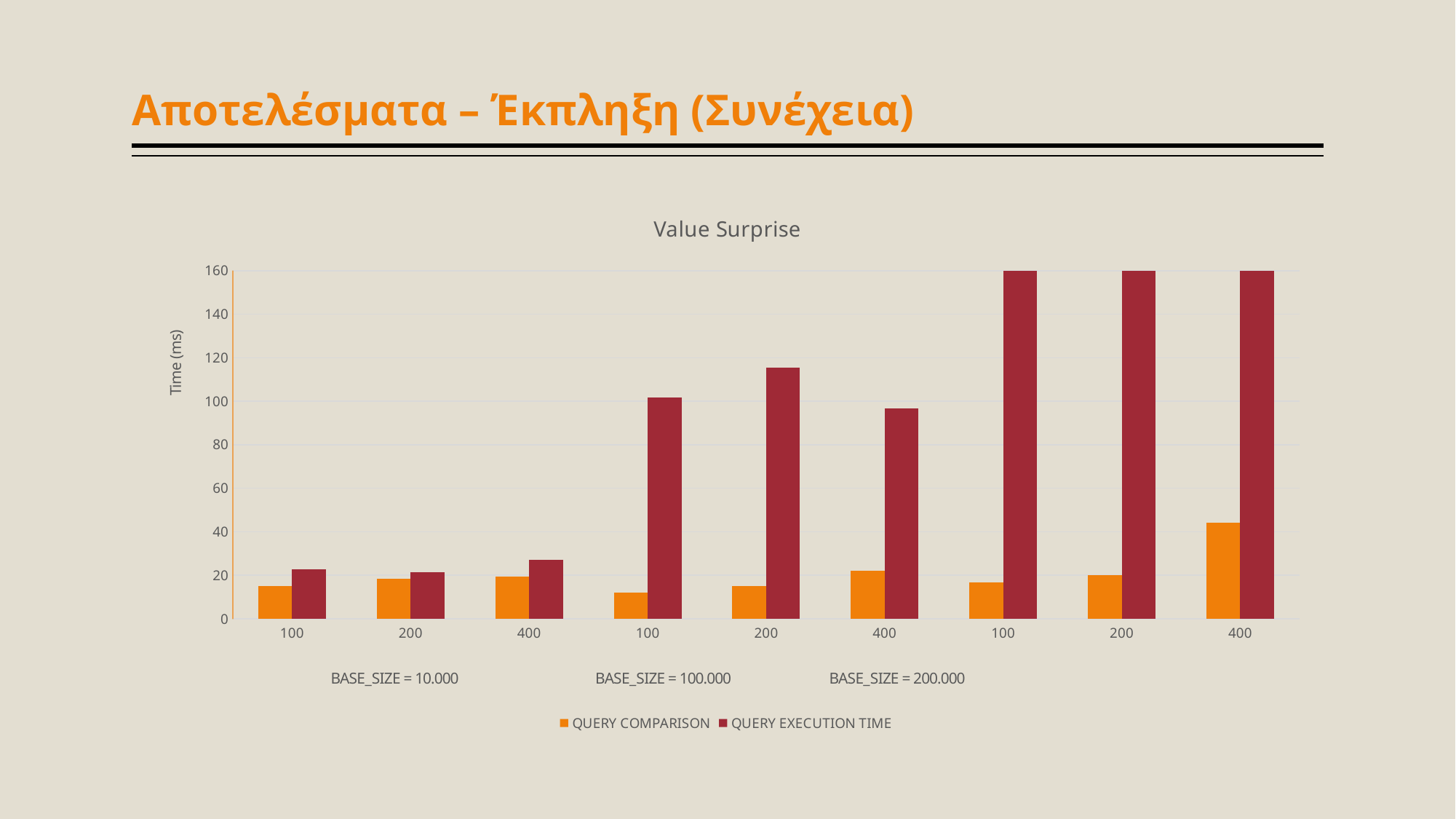
For 100 in the BASE_SIZE = 100.000 group, which series has the larger value, QUERY COMPARISON or QUERY EXECUTION TIME? QUERY EXECUTION TIME How many BASE_SIZE groups are shown on the x axis? 3 What is the label of the vertical axis? Time (ms) What kind of chart is shown on the slide? bar chart Which bar has the highest QUERY COMPARISON value? 400 in BASE_SIZE = 200.000 How many series does the legend list? 2 Within the BASE_SIZE = 200.000 group, do the QUERY COMPARISON values rise or fall from 100 to 400? rise Is the QUERY EXECUTION TIME value for 400 in the BASE_SIZE = 100.000 group greater or less than 80? greater Is the QUERY EXECUTION TIME value for 400 in the BASE_SIZE = 10.000 group greater or less than 40? less Is the QUERY COMPARISON value for 400 in the BASE_SIZE = 200.000 group greater or less than 60? less What is the title of the chart? Value Surprise